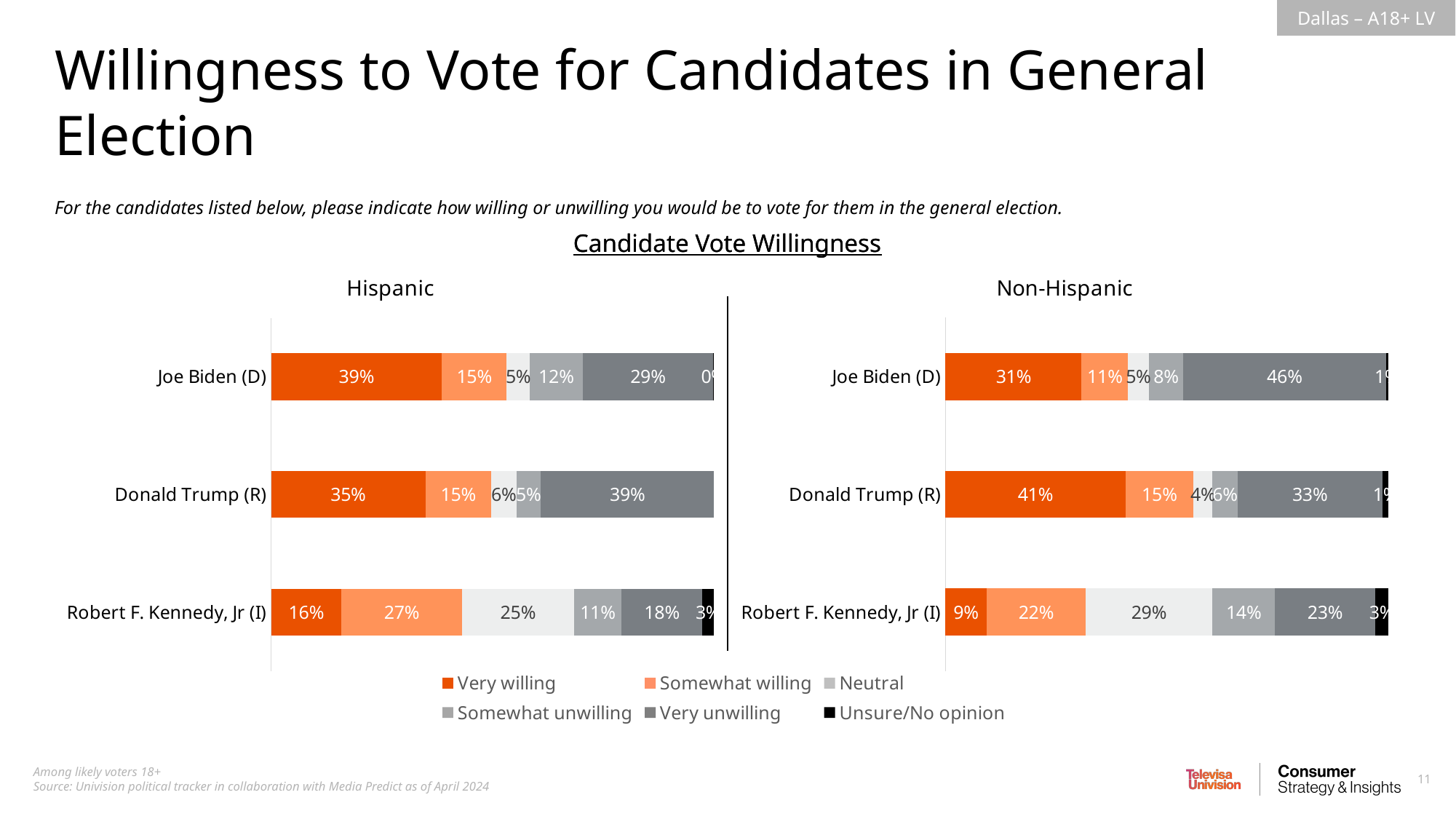
What is the title shown above the two charts? Candidate Vote Willingness In the Non-Hispanic chart, what percentage of respondents are very willing to vote for Donald Trump (R)? 41% In the Non-Hispanic chart, which candidate has the lowest 'Very willing' percentage? Robert F. Kennedy, Jr (I) In the Hispanic chart, what percentage of respondents are very willing to vote for Joe Biden (D)? 39% In the Hispanic chart, which candidate has the highest 'Very willing' percentage? Joe Biden (D) In the Non-Hispanic chart, is the 'Somewhat willing' percentage larger for Robert F. Kennedy, Jr (I) or for Donald Trump (R)? Robert F. Kennedy, Jr (I) In the Hispanic chart, what percentage of respondents are neutral about voting for Robert F. Kennedy, Jr (I)? 25% What kind of chart is used for the Non-Hispanic data? Stacked bar chart How many series does the legend list? 6 In the Non-Hispanic chart, what percentage of respondents are very unwilling to vote for Joe Biden (D)? 46% How many candidates are shown in the Hispanic chart? 3 In the Hispanic chart, what is the difference between the 'Very unwilling' percentages for Donald Trump (R) and Joe Biden (D)? 10%